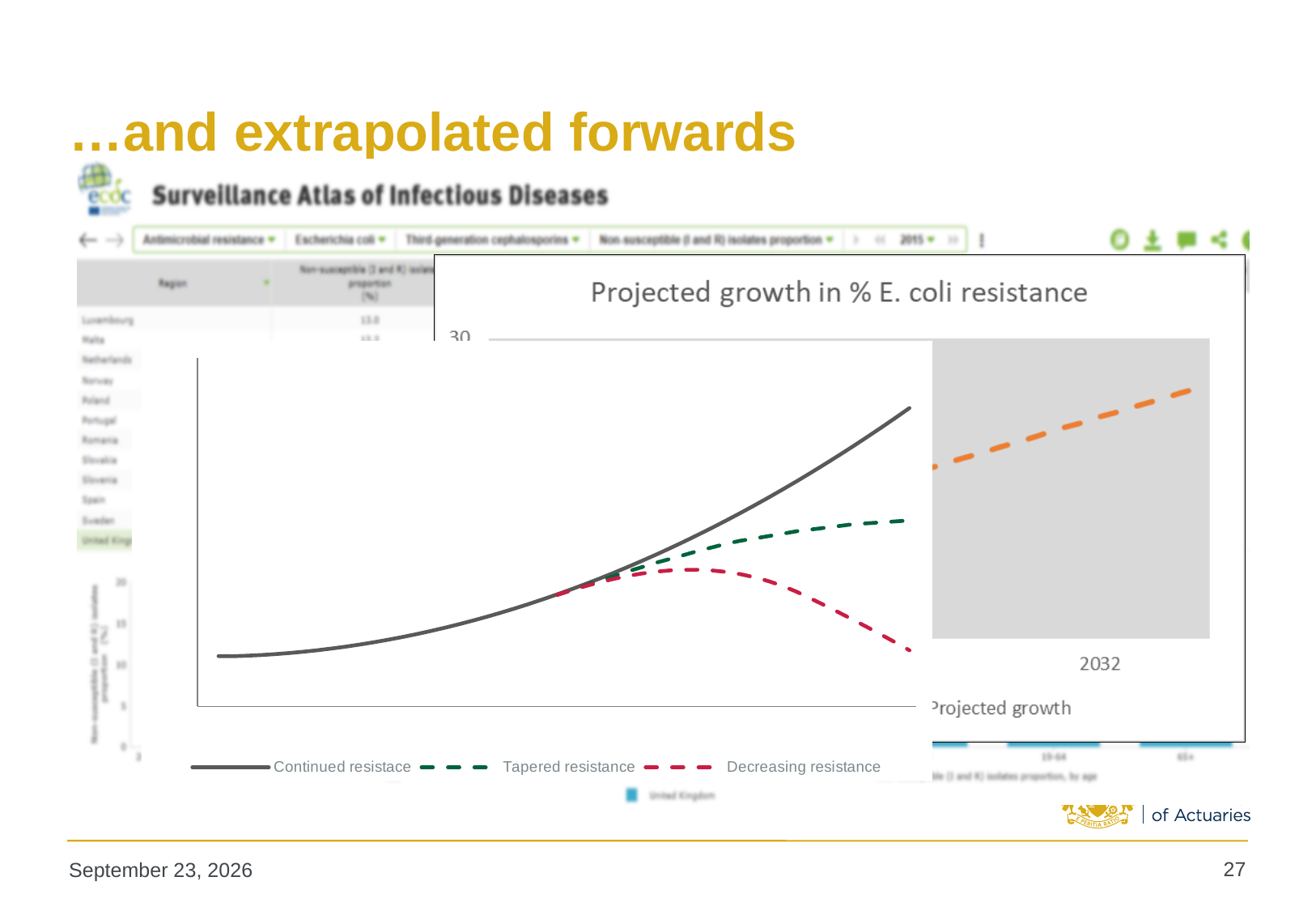
In the front line chart, at the right-hand end, is the 'Continued resistace' line higher or lower than the 'Tapered resistance' line? higher In the front line chart, which series is drawn as a red dashed line? Decreasing resistance What kind of chart is the front chart with the legend 'Continued resistace', 'Tapered resistance' and 'Decreasing resistance'? line chart In the front line chart, which series ends lowest at the right-hand end? Decreasing resistance What is the title of the chart partly visible behind the front line chart? Projected growth in % E. coli resistance In the front line chart, at the right-hand end, is the 'Tapered resistance' line higher or lower than the 'Decreasing resistance' line? higher In the front line chart, which series ends highest at the right-hand end? Continued resistace In the front line chart, does the 'Continued resistace' line rise or fall from left to right? rise How many series does the legend of the front line chart list? 3